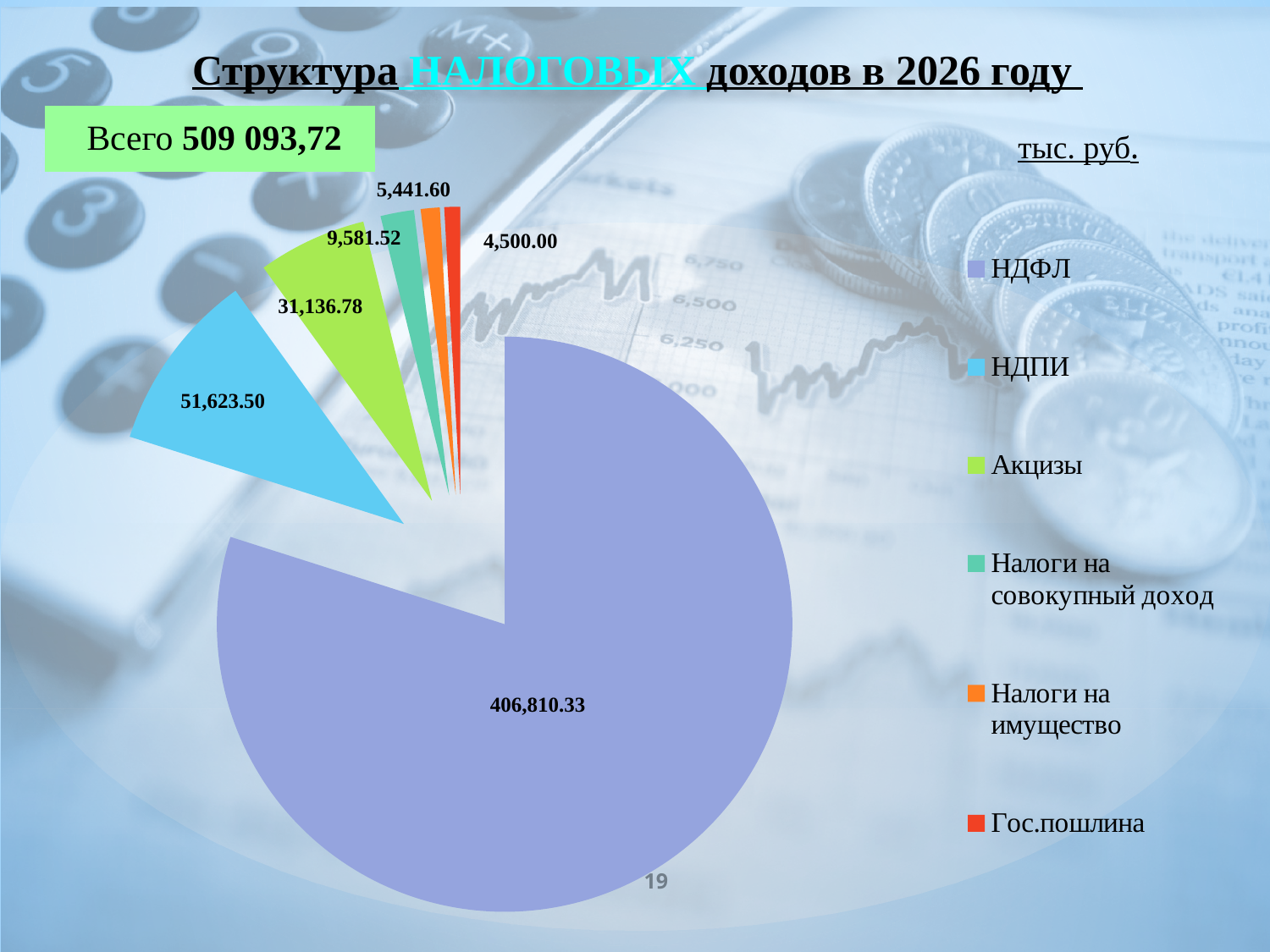
How many categories does the legend of the pie chart list? 6 Which category has the smallest slice in the pie chart? Гос.пошлина What is the value for НДФЛ in the pie chart? 406,810.33 What total value (Всего) is stated on the slide for tax revenues? 509 093,72 What is the difference between the values for НДПИ and Акцизы? 20,486.72 What is the difference between the values for Налоги на совокупный доход and Налоги на имущество? 4,139.92 What is the value for НДПИ in the pie chart? 51,623.50 What is the value for Акцизы in the pie chart? 31,136.78 Which category has the largest slice in the pie chart? НДФЛ What type of chart is shown on the slide? pie chart Which is larger in the pie chart, НДПИ or Акцизы? НДПИ What is the value for Гос.пошлина in the pie chart? 4,500.00